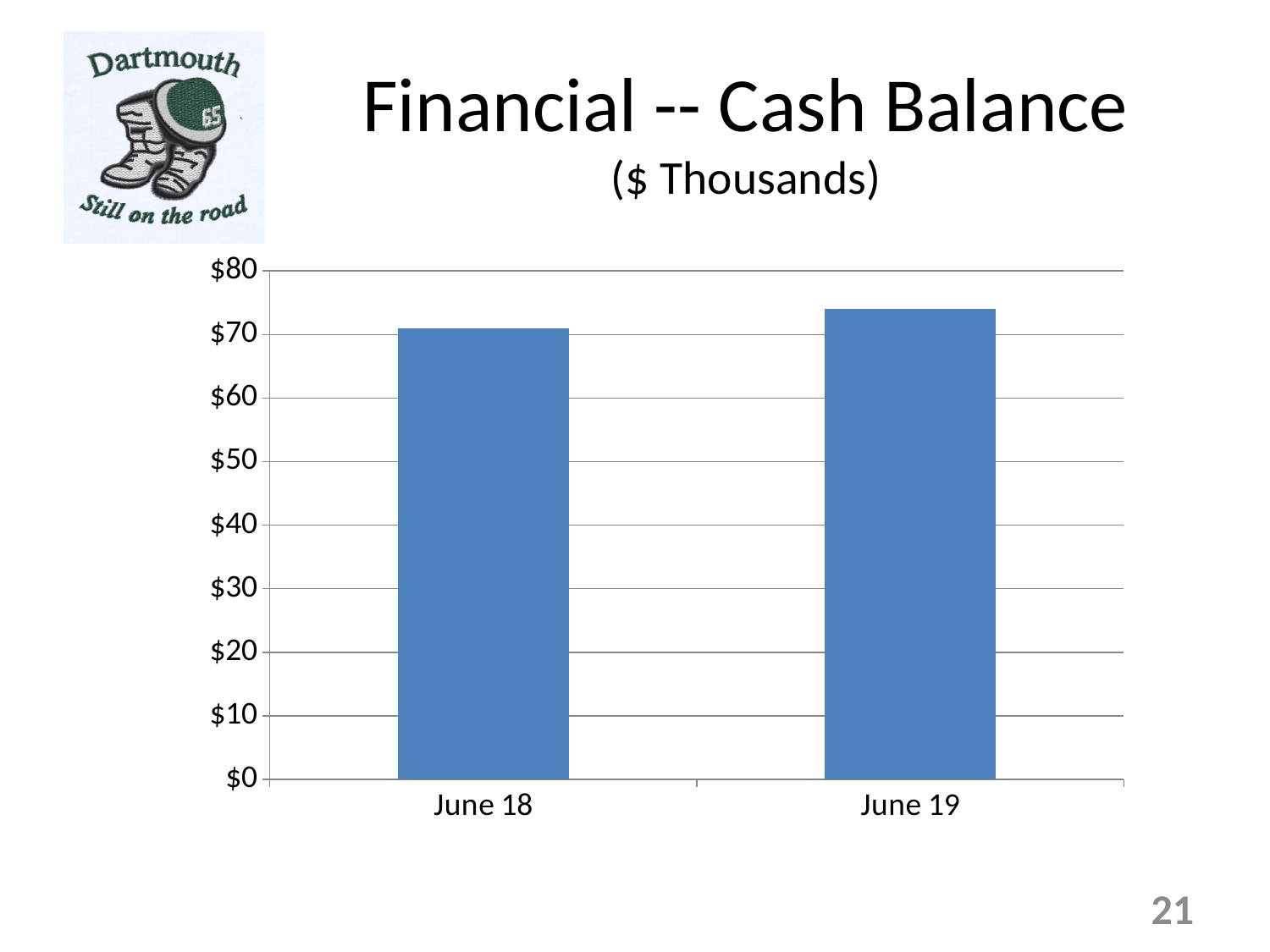
What kind of chart is shown on the slide? bar chart In what units are the chart values expressed, according to the subtitle? $ Thousands Which category has the highest cash balance? June 19 Is the value for June 18 greater or less than $60? greater What is the title of the chart on the slide? Financial -- Cash Balance Which category has the lowest cash balance? June 18 Is the value for June 19 greater or less than $70? greater Does the cash balance rise or fall from June 18 to June 19? rise Is the value for June 18 greater or less than $80? less Which category has the higher cash balance, June 18 or June 19? June 19 How many categories are plotted on the x axis of the chart? 2